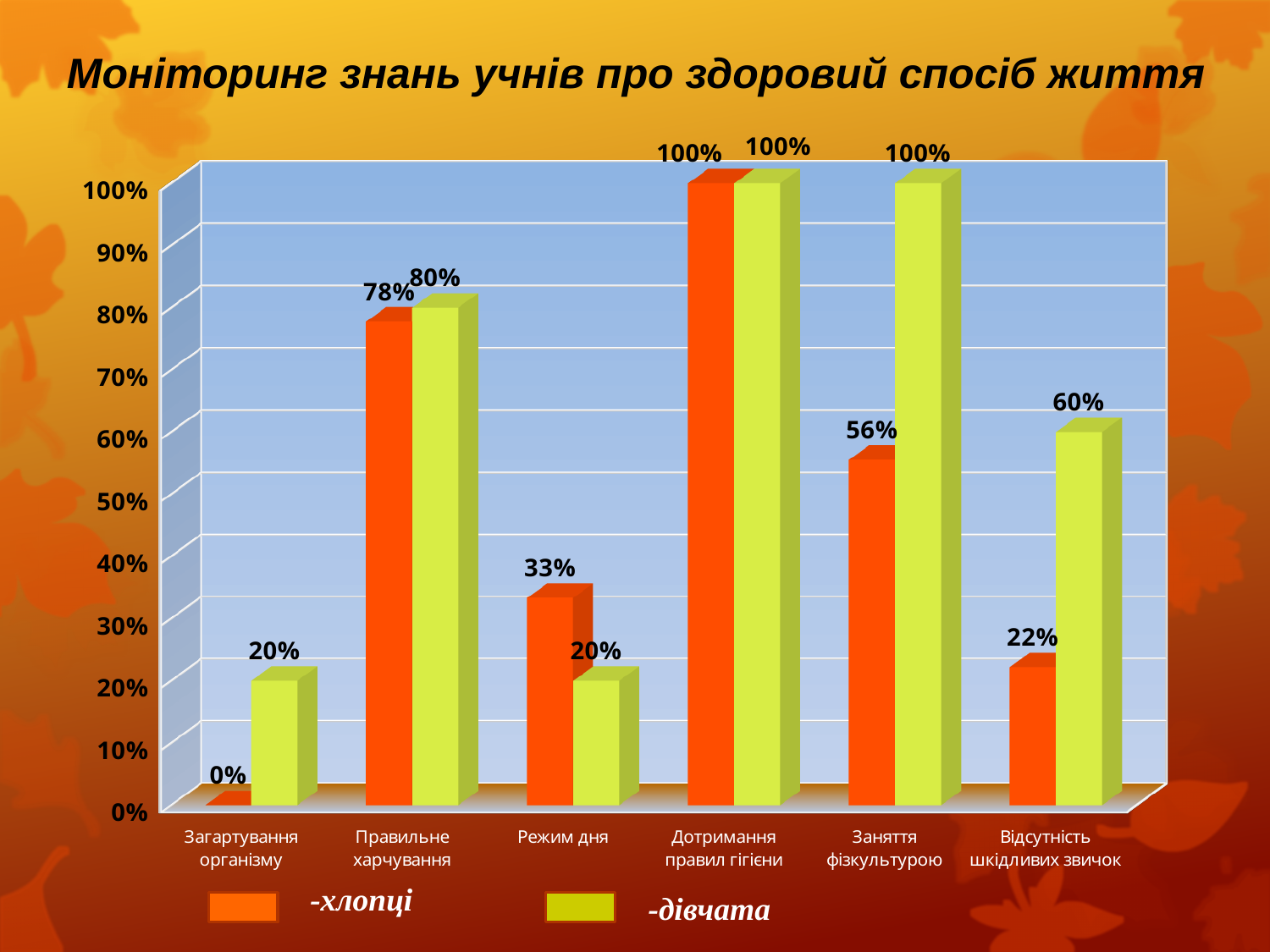
Which category has the lowest value for дівчата? Загартування організму and Режим дня (both 20%) What is the value for дівчата in the category Відсутність шкідливих звичок? 60% What kind of chart is shown on the slide? Bar chart What is the difference between the дівчата and хлопці values in the category Заняття фізкультурою? 44% In the category Правильне харчування, which is larger: the value for хлопці or for дівчата? дівчата What is the difference between the хлопці and дівчата values in the category Режим дня? 13% What is the value for хлопці in the category Режим дня? 33% How many series does the legend list? 2 What is the value for дівчата in the category Заняття фізкультурою? 100% How many categories are shown on the x axis? 6 What is the value for хлопці in the category Загартування організму? 0% Which category has the lowest value for хлопці? Загартування організму